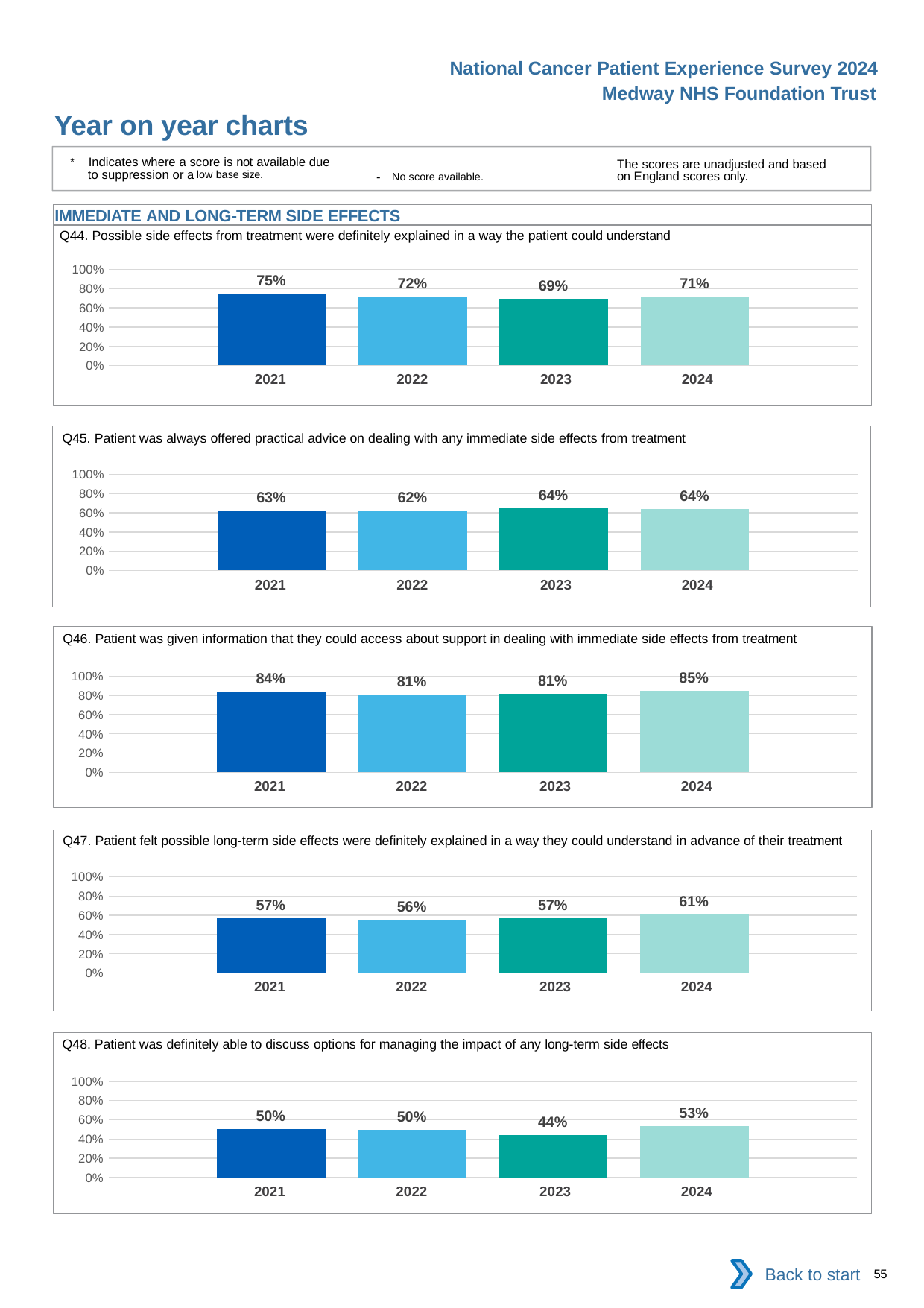
In the Q46 chart, which year has the highest value? 2024 In the Q48 chart, which year has the highest value? 2024 In the Q46 chart, what is the value for 2022? 81% In the Q44 chart, which year has the lowest value? 2023 In the Q47 chart, what is the difference between the 2024 value and the 2021 value? 4 percentage points In the Q44 chart, what is the value for 2021? 75% How many years are shown in the Q48 chart? 4 In the Q45 chart, what is the value for 2024? 64% In the Q45 chart, what is the difference between the 2023 value and the 2022 value? 2 percentage points What type of chart is the Q44 chart? Bar chart In the Q48 chart, what is the value for 2023? 44% In the Q47 chart, is the value for 2024 larger than the value for 2022? Yes